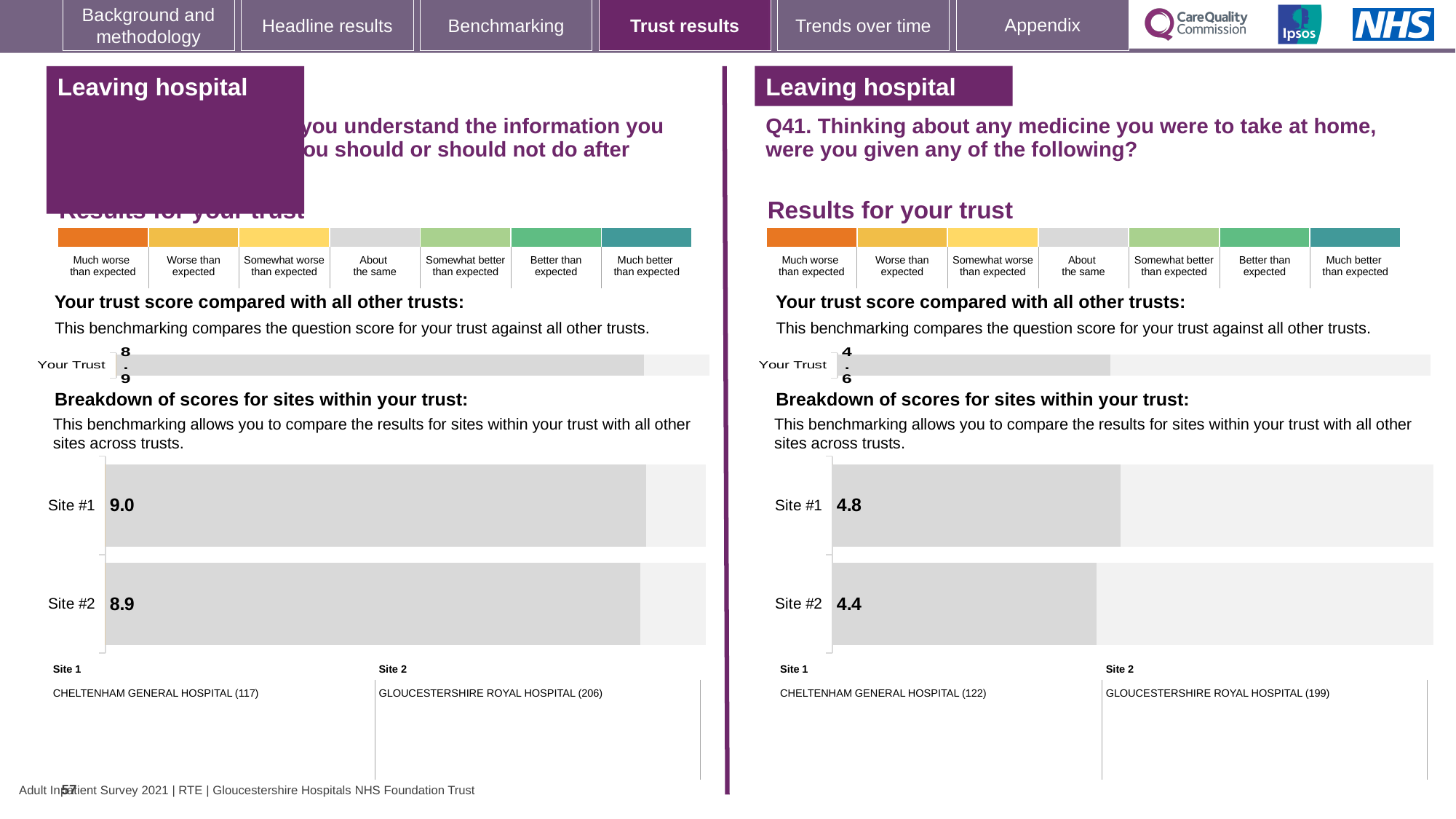
On the left-hand panel, what is the score shown for Your Trust? 8.9 In the left-hand site breakdown chart, what is the score for Site #1? 9.0 In the right-hand (Q41) site breakdown chart, which site has the higher score? Site #1 In the right-hand (Q41) site breakdown chart, what is the difference between the Site #1 and Site #2 scores? 0.4 What kind of chart is used for the site breakdown on the right-hand (Q41) panel? Bar chart How many sites are shown in the right-hand (Q41) site breakdown chart? 2 In the right-hand (Q41) site breakdown chart, what is the score for Site #2? 4.4 In the left-hand site breakdown chart, what is the score for Site #2? 8.9 In the left-hand site breakdown chart, what is the difference between the Site #1 and Site #2 scores? 0.1 In the right-hand (Q41) site breakdown chart, what is the score for Site #1? 4.8 On the right-hand (Q41) panel, what is the score shown for Your Trust? 4.6 In the right-hand (Q41) panel, which hospital is listed as Site 1? Cheltenham General Hospital (122)